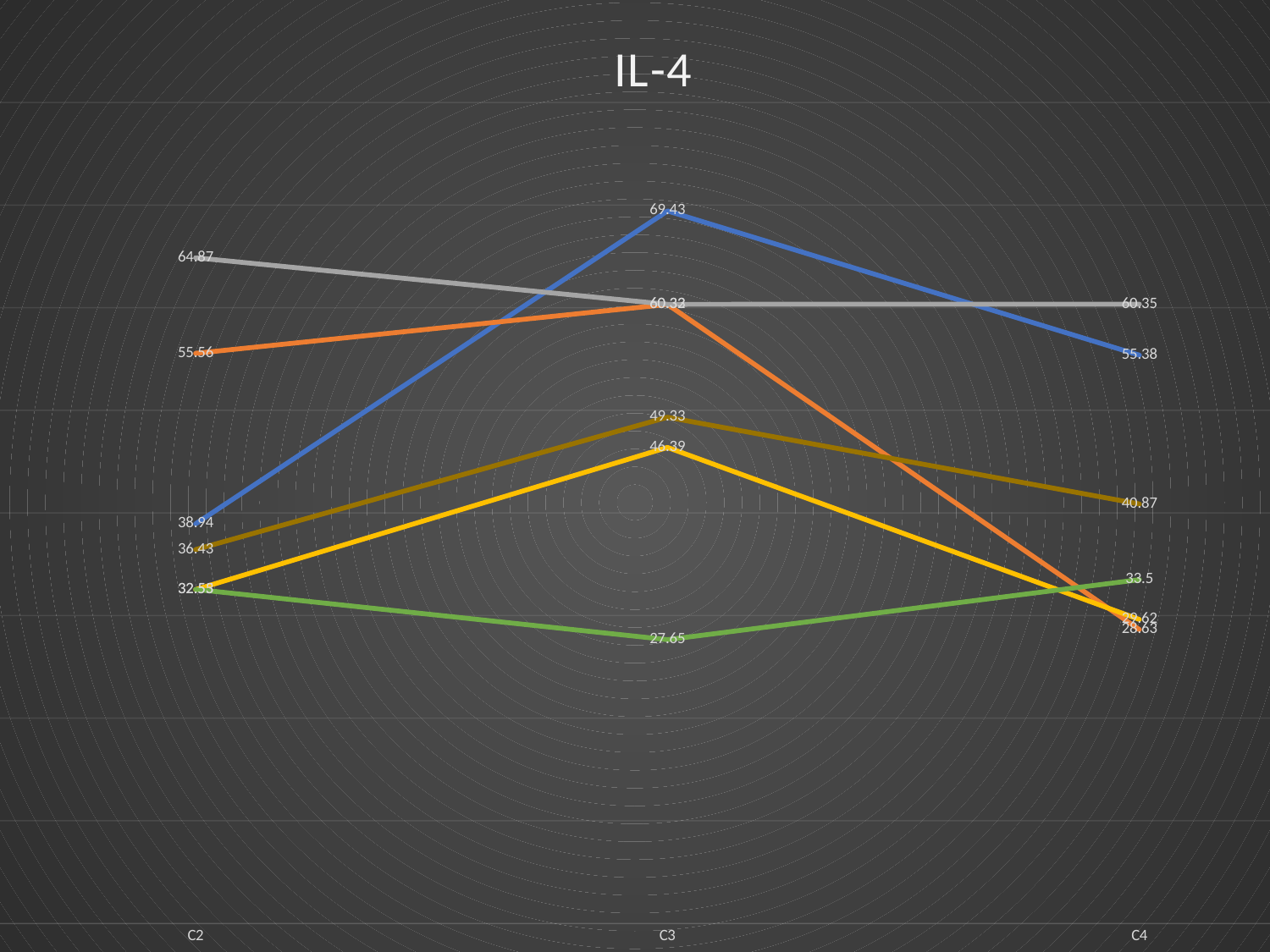
What is the value of the gray line at C2? 64.87 How many categories are shown on the x axis? 3 What is the value of the blue line at C3? 69.43 What is the difference between the blue line's values at C3 and C2? 30.49 What is the title of the chart? IL-4 What is the lowest value plotted at C3? 27.65 How does the blue line change from C2 to C3 to C4? rises then falls What kind of chart is shown on the slide? line chart Which category has the highest value for the blue line? C3 What is the value of the dark yellow line at C4? 40.87 Which is larger: the blue line at C3 or the gray line at C2? the blue line at C3 What is the value of the green line at C3? 27.65